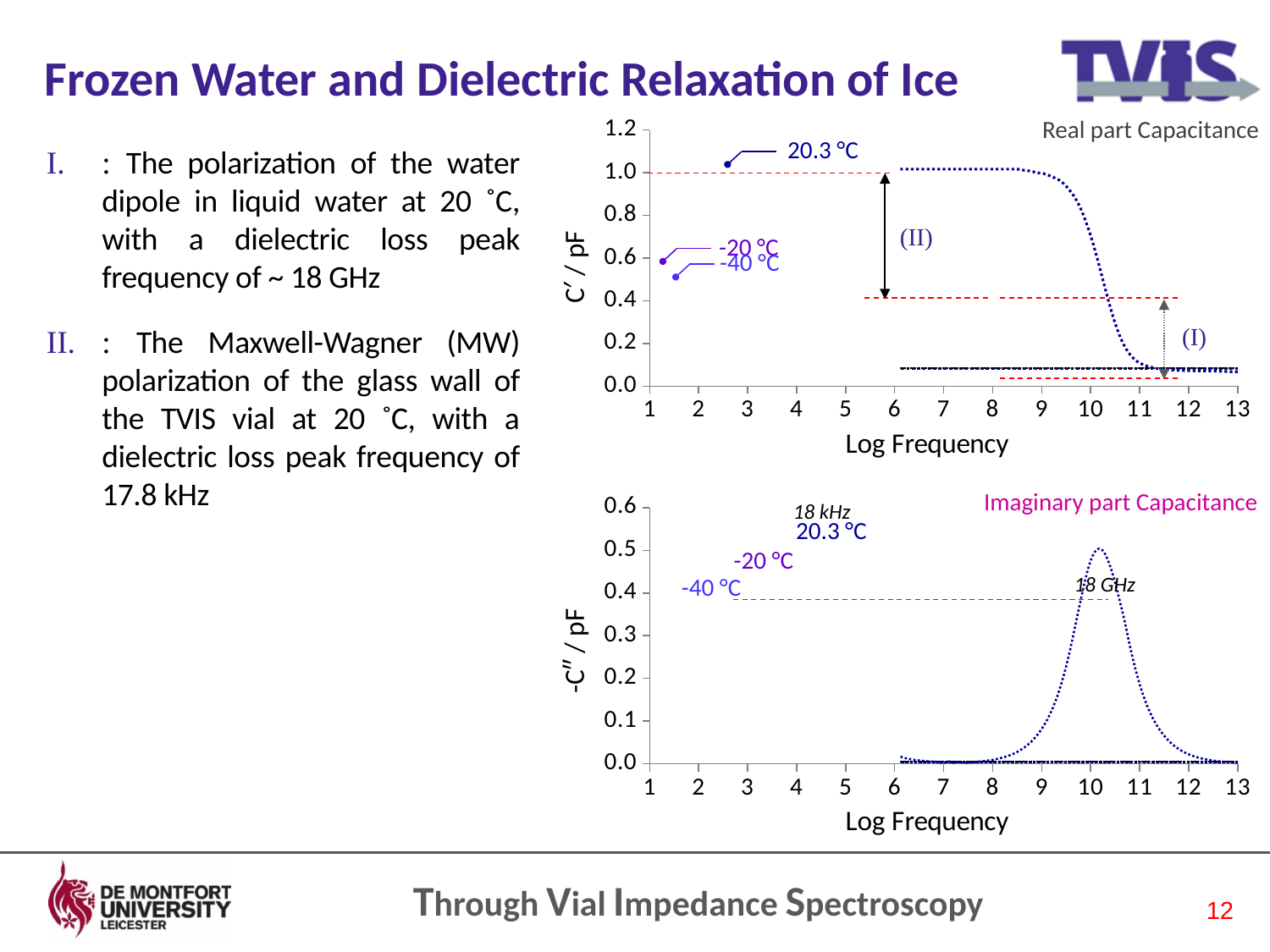
In the Imaginary part Capacitance chart, is the peak value of the 20.3 °C curve greater or less than 0.4? greater What is the y-axis label of the Real part Capacitance chart? C′ / pF In the Real part Capacitance chart, is the value of the 20.3 °C curve at Log Frequency 7 greater or less than 0.8? greater What frequency annotation is placed at the peak of the curve in the Imaginary part Capacitance chart? 18 GHz In the Real part Capacitance chart, do the values of the 20.3 °C curve rise or fall as Log Frequency increases from 6 to 13? fall In the Imaginary part Capacitance chart, is the value of the 20.3 °C curve at Log Frequency 7 greater or less than 0.1? less How many temperature labels are shown in the Imaginary part Capacitance chart? 3 What kind of chart is the Real part Capacitance chart? line chart